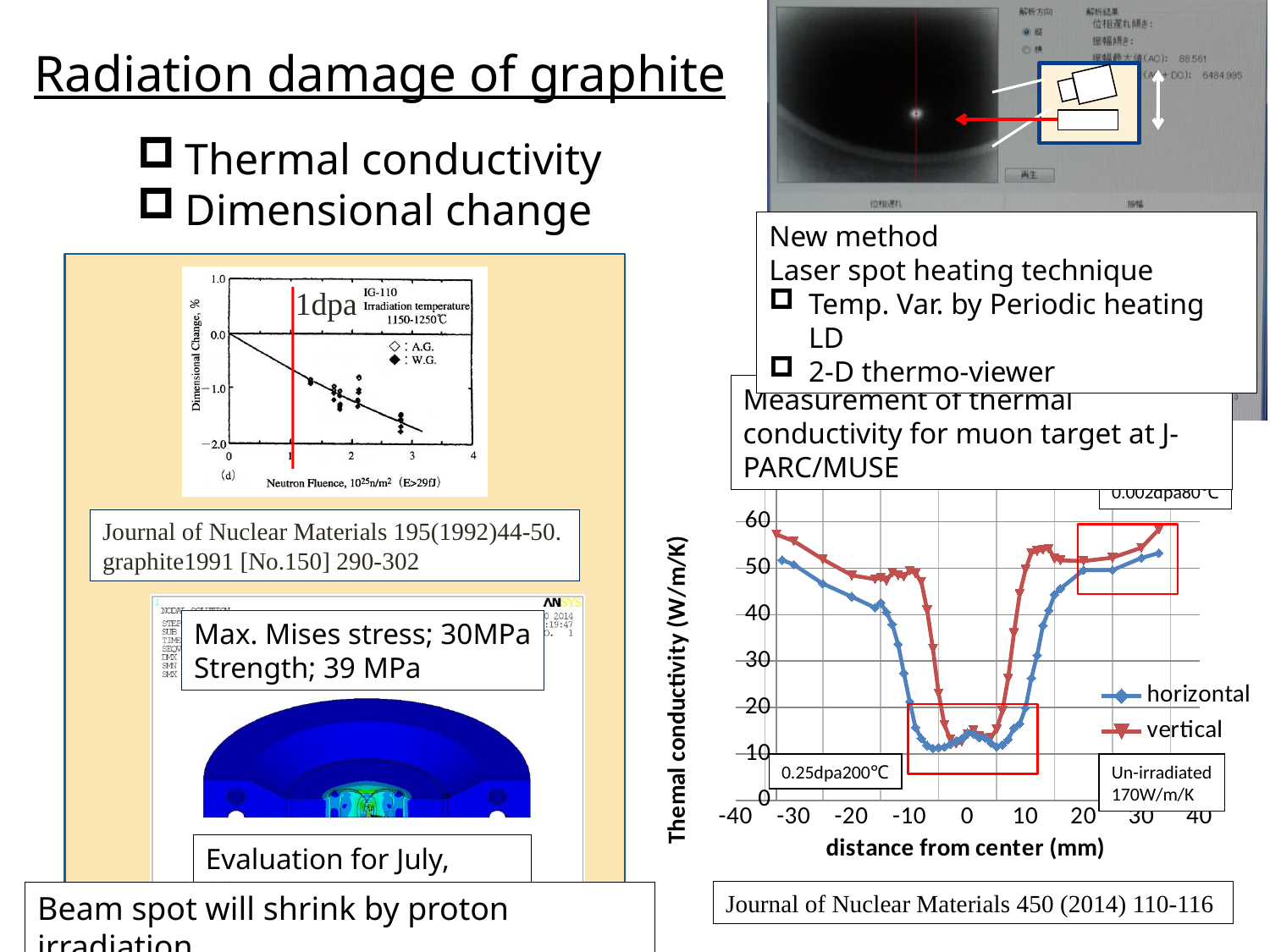
On the thermal conductivity chart on the right, is the vertical series value at -30 mm greater or less than 50? greater On the thermal conductivity chart on the right, do the values rise or fall as the distance from center goes from 0 mm to 30 mm? rise On the thermal conductivity chart on the right, how many series does the legend list? 2 On the thermal conductivity chart on the right, is the horizontal series value at 0 mm greater or less than 20? less On the thermal conductivity chart on the right, is the horizontal series value at -30 mm greater or less than 40? greater On the thermal conductivity chart on the right, what are the two series named in the legend? horizontal and vertical On the dimensional change chart on the left, does the dimensional change rise or fall as neutron fluence increases? fall On the thermal conductivity chart on the right, do the values rise or fall as the distance from center goes from -30 mm to 0 mm? fall On the thermal conductivity chart on the right, what is the label of the x axis? distance from center (mm) On the thermal conductivity chart on the right, what kind of chart is it? line chart On the dimensional change chart on the left, how many series does the legend list? 2 On the thermal conductivity chart on the right, which series has the larger value at -30 mm, horizontal or vertical? vertical